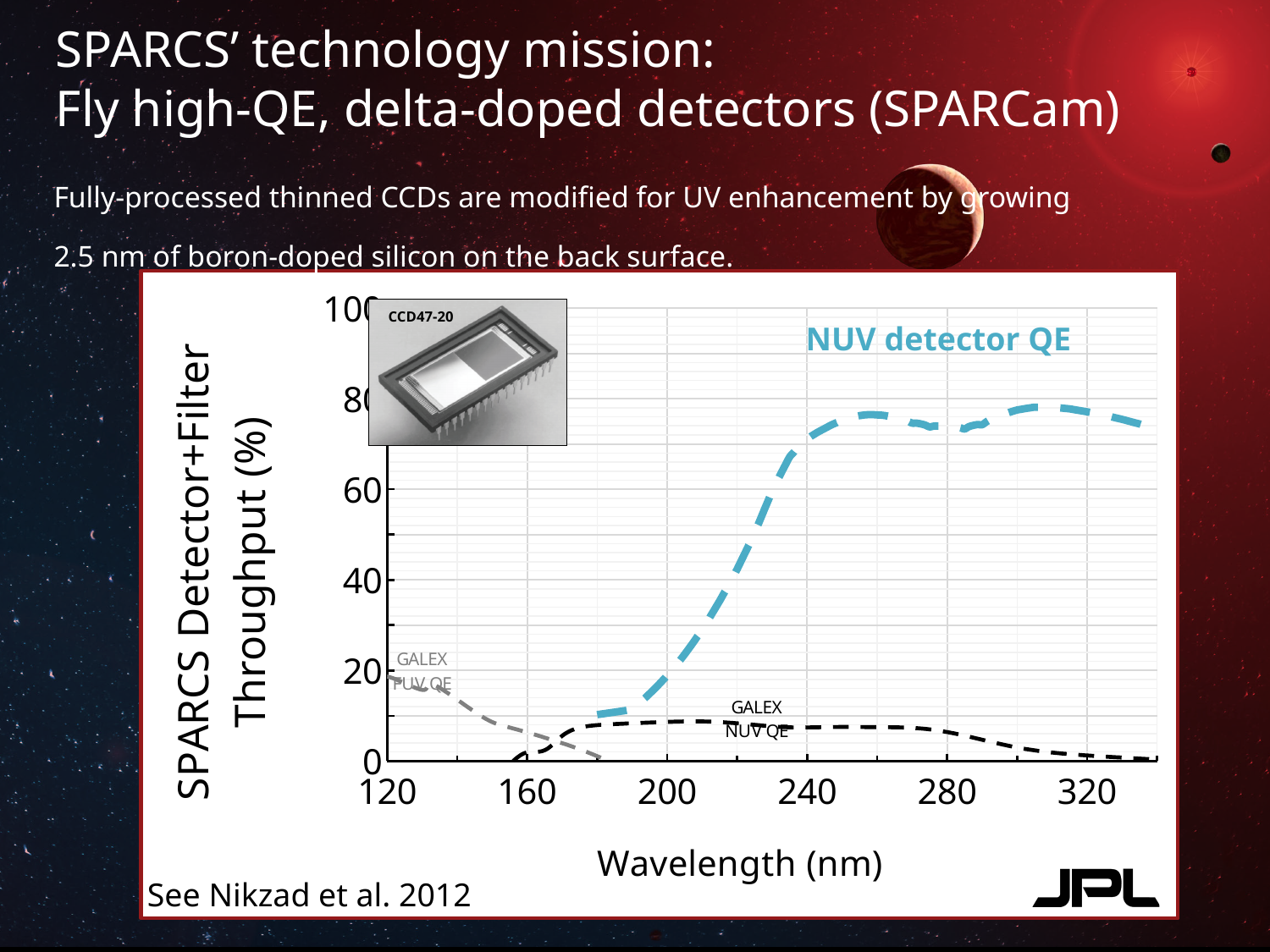
What is the label of the y axis of the chart? SPARCS Detector+Filter Throughput (%) How many curves are plotted on the chart? 3 Is the value of the NUV detector QE curve at 200 nm greater or less than 40? less What is the label of the x axis of the chart? Wavelength (nm) At 280 nm, which is larger: the NUV detector QE curve or the GALEX NUV QE curve? NUV detector QE What kind of chart is shown on the slide? line chart Does the NUV detector QE curve rise or fall between 180 nm and 240 nm? rise Is the value of the NUV detector QE curve at 280 nm greater or less than 60? greater Is the value of the GALEX FUV QE curve at 120 nm greater or less than 40? less Which curve reaches the highest throughput value on the chart? NUV detector QE Does the GALEX FUV QE curve rise or fall between 120 nm and 180 nm? fall